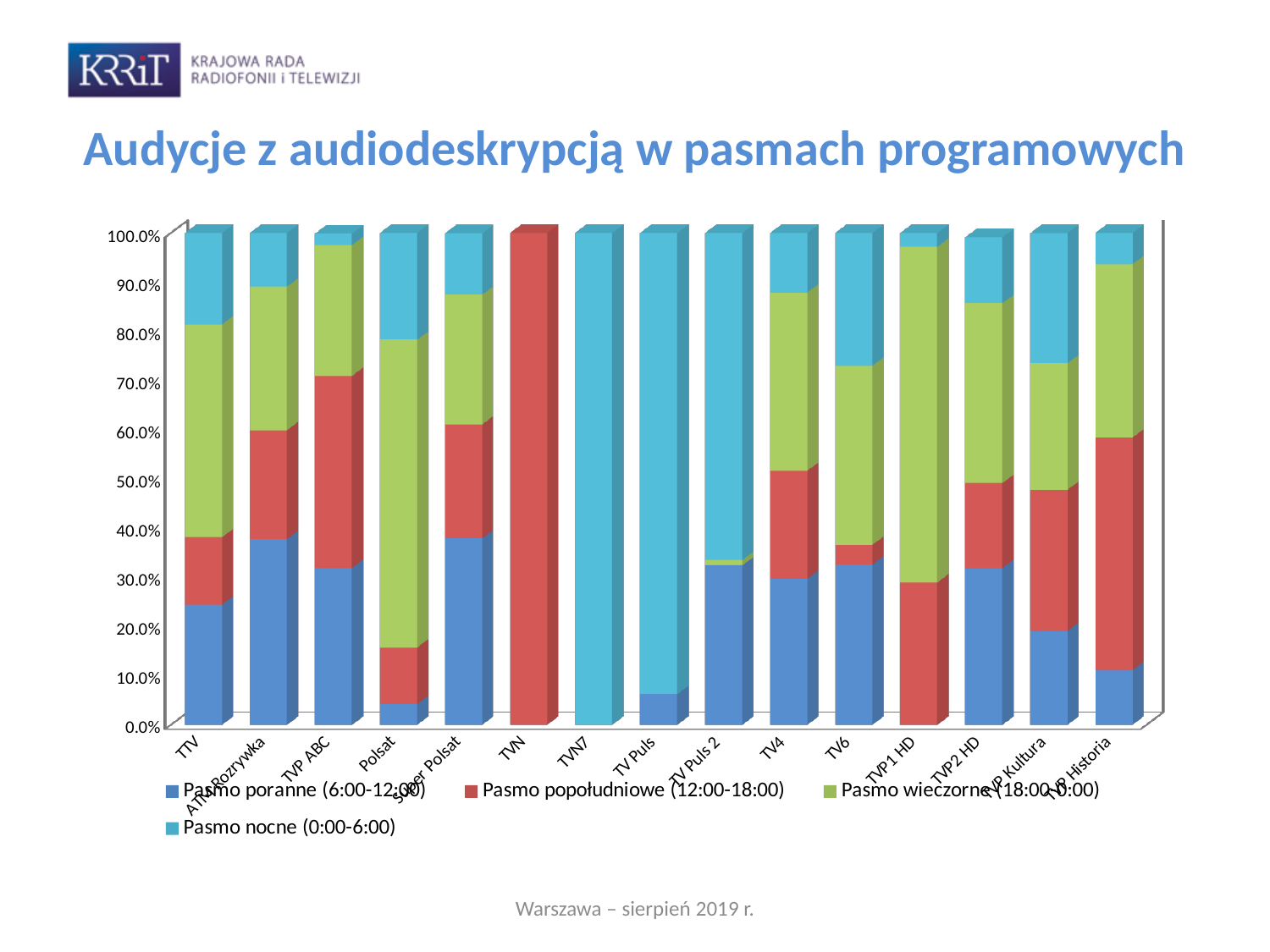
How many TV channels (categories) are shown on the x axis of the chart? 15 Which legend entry corresponds to the time band 0:00-6:00? Pasmo nocne (0:00-6:00) Is the value of Pasmo poranne (6:00-12:00) for Super Polsat greater or less than 30.0%? greater How many series does the chart legend list? 4 What is the title of the chart on the slide? Audycje z audiodeskrypcją w pasmach programowych Is the value of Pasmo poranne (6:00-12:00) for TVP Kultura greater or less than 30.0%? less What is the total of the stacked bar for TTV? 100.0% Which series makes up the entire bar for TVN? Pasmo popołudniowe (12:00-18:00) What kind of chart is shown on the slide? stacked bar chart Which is larger, the Pasmo poranne (6:00-12:00) value for TTV or for Polsat? TTV Is the value of Pasmo poranne (6:00-12:00) for TTV greater or less than 20.0%? greater